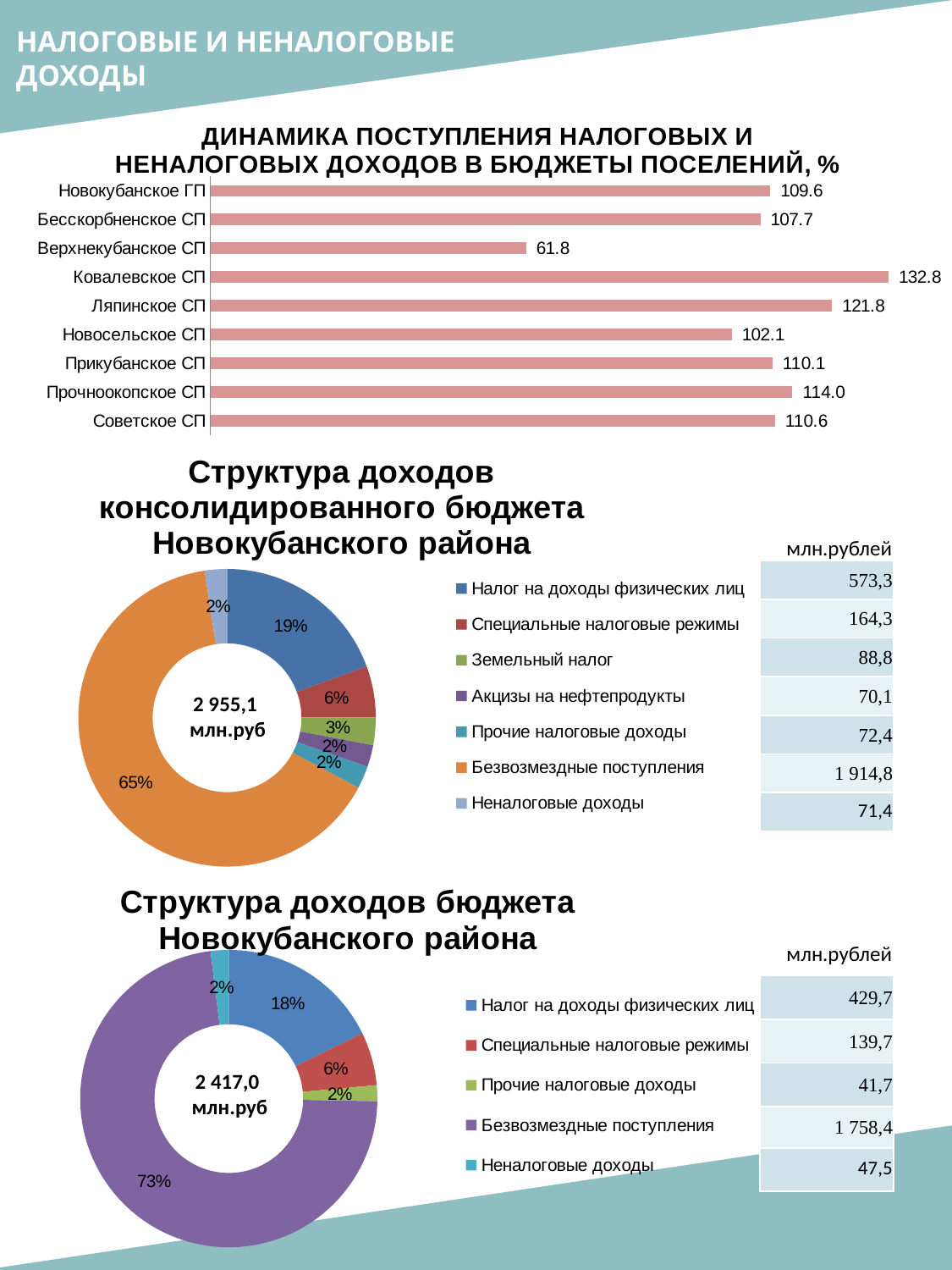
What type of chart is 'Динамика поступления налоговых и неналоговых доходов в бюджеты поселений, %'? bar chart In the chart 'Структура доходов консолидированного бюджета Новокубанского района', what share does Безвозмездные поступления have? 65% In the bar chart 'Динамика поступления налоговых и неналоговых доходов в бюджеты поселений, %', which settlement has the lowest value? Верхнекубанское СП In the bar chart 'Динамика поступления налоговых и неналоговых доходов в бюджеты поселений, %', what is the difference between Ляпинское СП and Новосельское СП? 19.7 How many categories does the legend of the chart 'Структура доходов консолидированного бюджета Новокубанского района' list? 7 In the bar chart 'Динамика поступления налоговых и неналоговых доходов в бюджеты поселений, %', which is larger: Прочноокопское СП or Прикубанское СП? Прочноокопское СП In the bar chart 'Динамика поступления налоговых и неналоговых доходов в бюджеты поселений, %', how many settlements are shown? 9 In the bar chart 'Динамика поступления налоговых и неналоговых доходов в бюджеты поселений, %', which settlement has the highest value? Ковалевское СП What total is shown in the centre of the chart 'Структура доходов бюджета Новокубанского района'? 2 417,0 млн.руб In the chart 'Структура доходов бюджета Новокубанского района', what share does Безвозмездные поступления have? 73% In the chart 'Структура доходов консолидированного бюджета Новокубанского района', what is the value in млн.рублей for Налог на доходы физических лиц? 573,3 In the bar chart 'Динамика поступления налоговых и неналоговых доходов в бюджеты поселений, %', what is the value for Ковалевское СП? 132.8